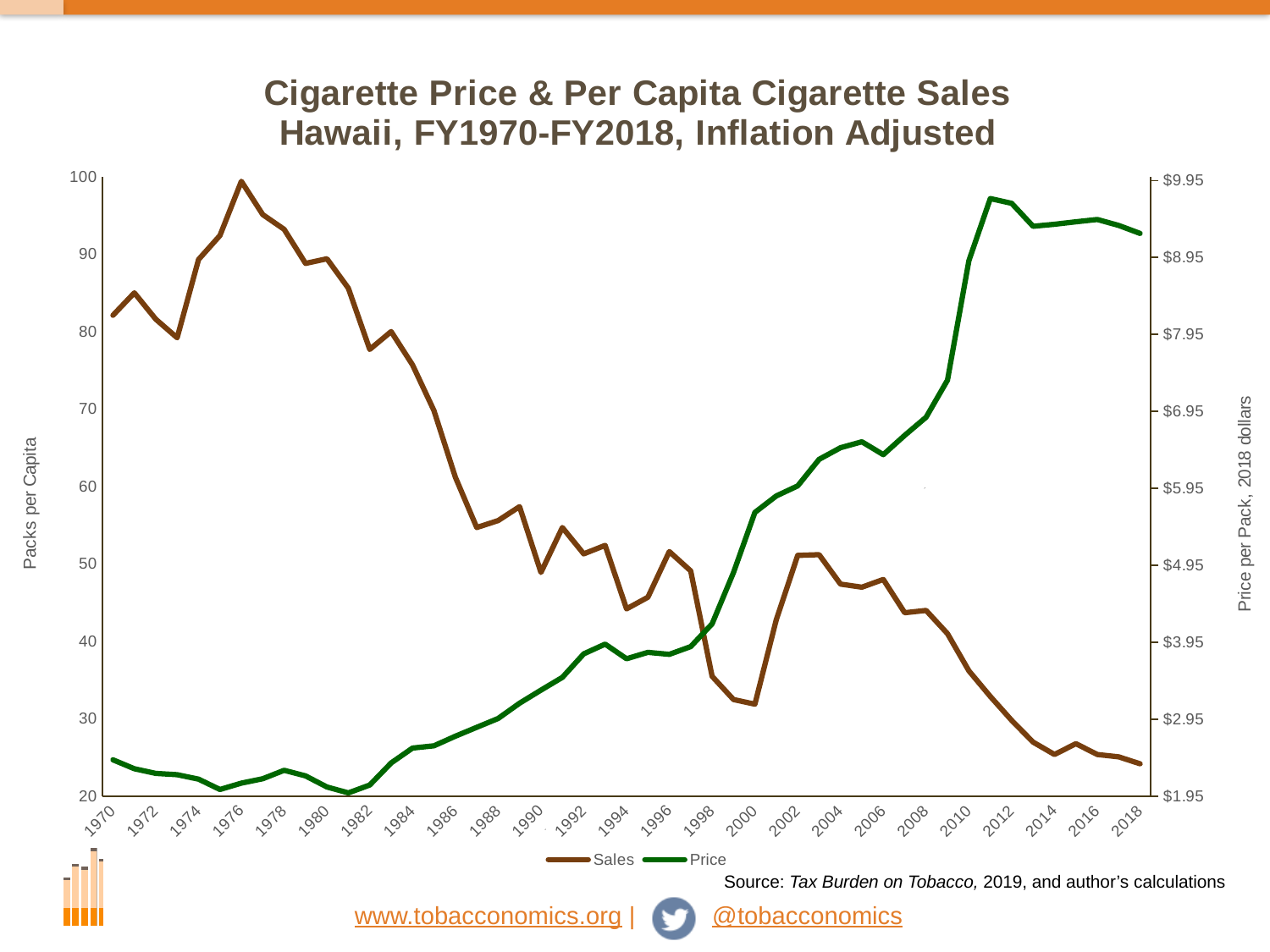
What is the title of the right-hand vertical axis? Price per Pack, 2018 dollars What kind of chart is shown on the slide? line chart Does the Sales series rise or fall overall from 1970 to 2018? fall In which year does the Sales series reach its highest value? 1976 What are the two series named in the legend? Sales and Price Is the Sales value for 2000 greater or less than 40 packs per capita? less How many series does the legend list? 2 Is the Price value for 1980 greater or less than $2.95? less Is the Sales value for 2018 greater or less than 30 packs per capita? less Does the Price series rise or fall overall from 1970 to 2018? rise